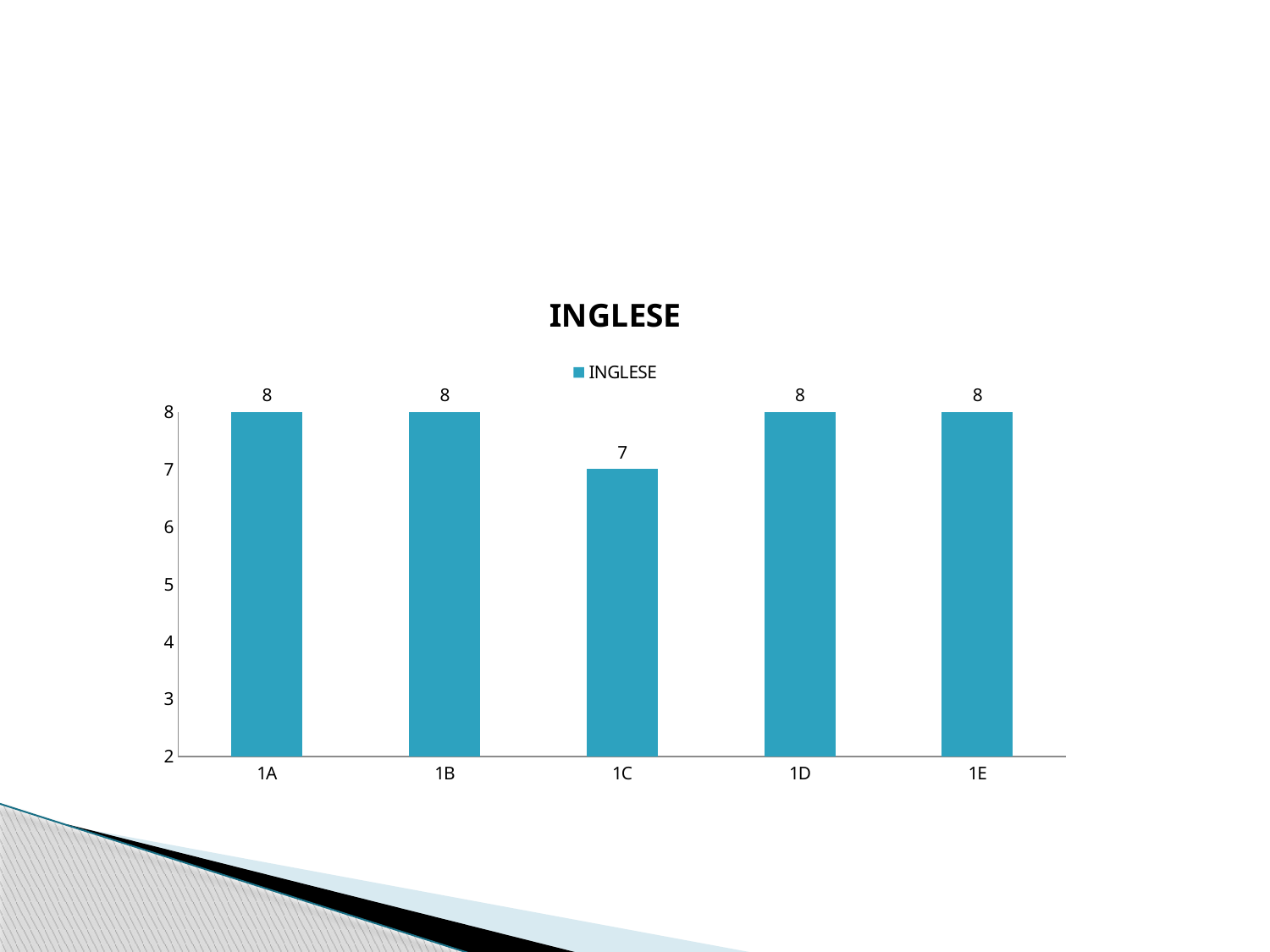
Which category has the lowest value? 1C Is the value for 1C greater or less than 5? greater Which is larger, the value for 1C or the value for 1D? 1D How many series does the legend list? 1 What kind of chart is shown? bar chart How many categories are shown on the x axis? 5 What is the name of the series in the legend? INGLESE What is the value for 1C? 7 What is the difference between the values for 1B and 1C? 1 What is the value for 1E? 8 What is the title of the chart? INGLESE What is the value for 1A? 8